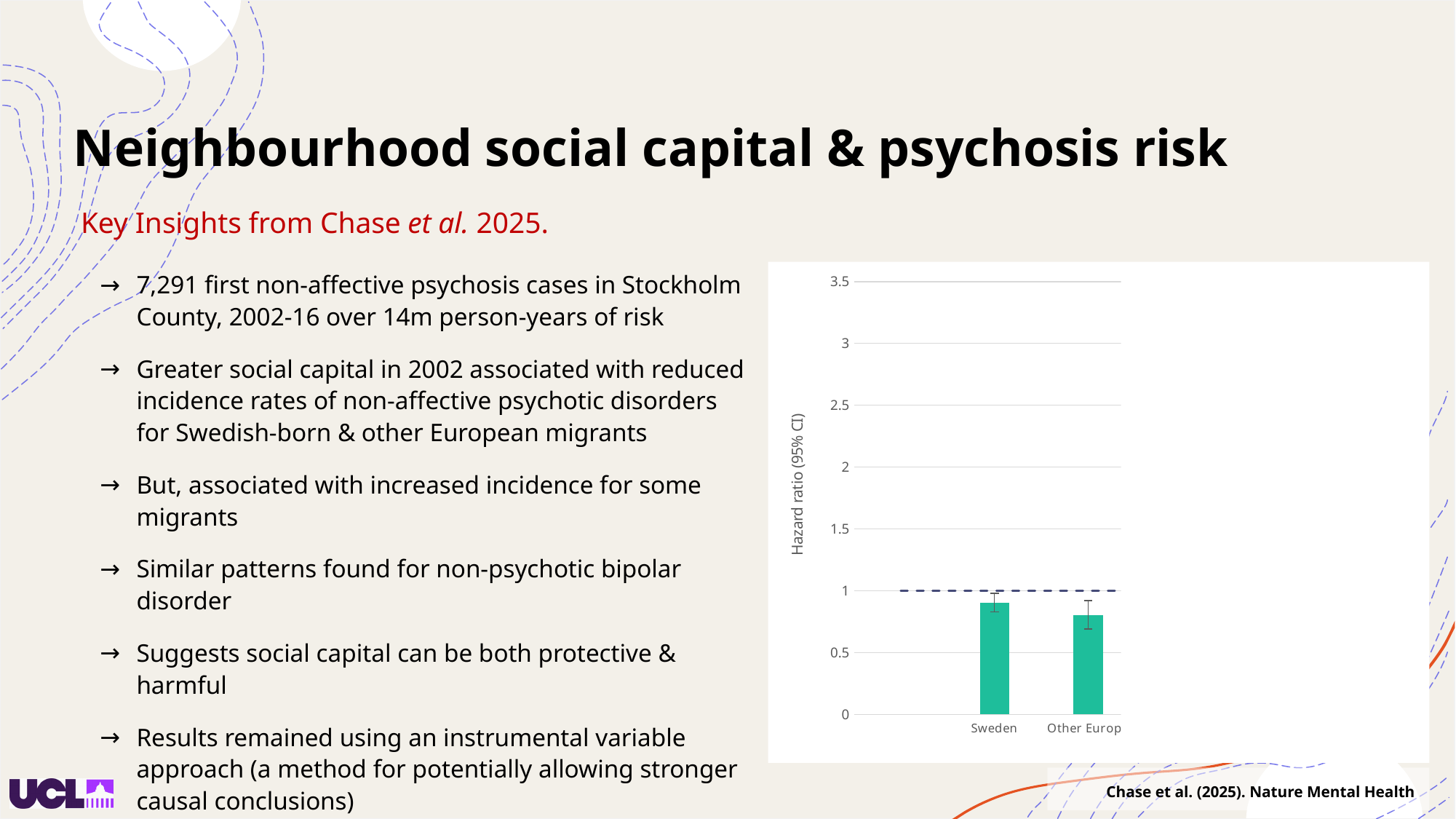
Is the hazard ratio for Sweden greater or less than 0.5? greater What kind of chart is shown on the right of the slide? bar chart What is the label on the vertical axis of the chart? Hazard ratio (95% CI) Is the hazard ratio for Other Europ greater or less than 0.5? greater Is the hazard ratio for Other Europ greater or less than 1? less What is the highest tick value shown on the vertical axis? 3.5 Which category has the lowest hazard ratio in the chart? Other Europ Which category has the taller bar, Sweden or Other Europ? Sweden How many bars are plotted in the chart? 2 At what value on the vertical axis is the dashed horizontal reference line drawn? 1 Which category has the highest hazard ratio in the chart? Sweden